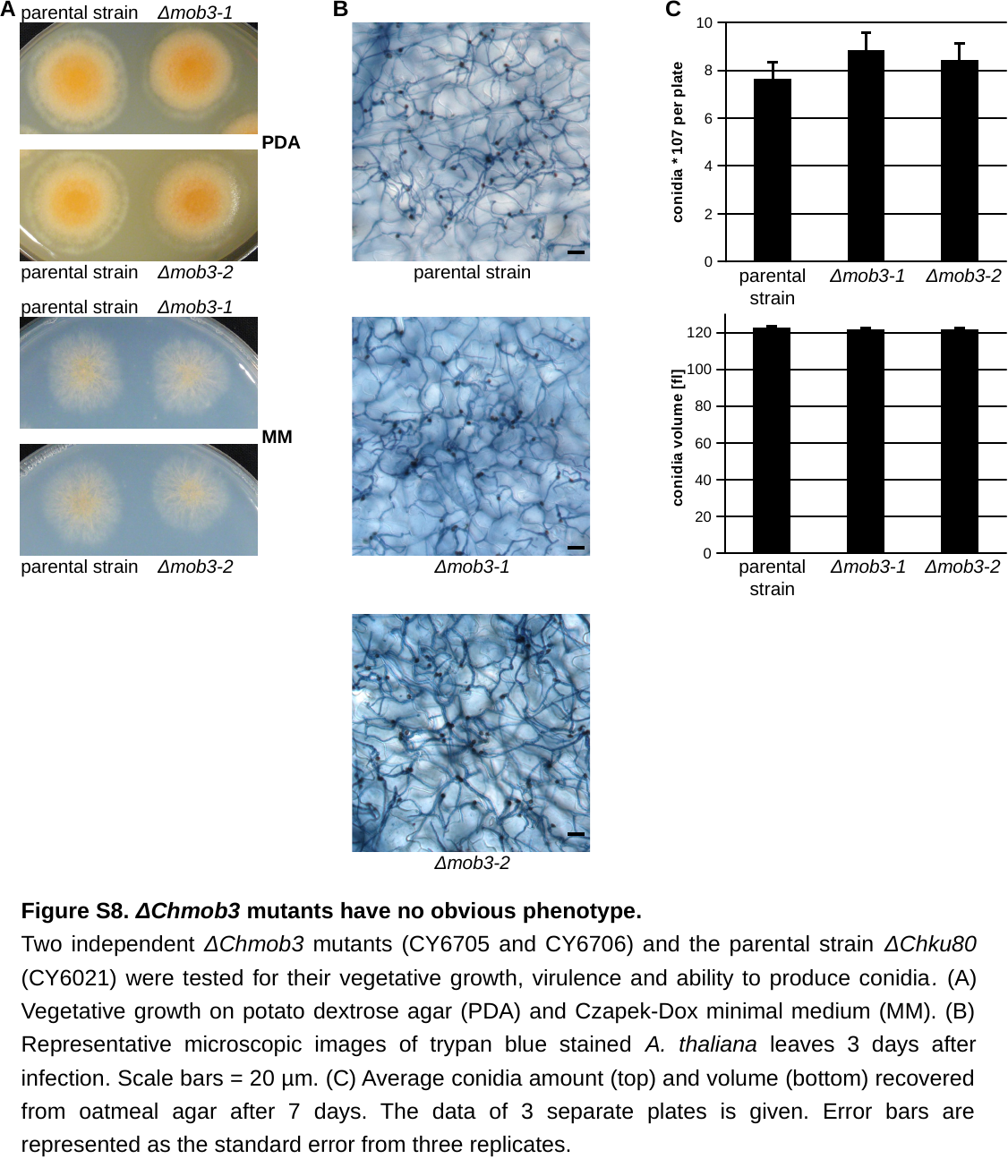
In the bottom chart in panel C (conidia volume [fl]), is the value for Δmob3-2 greater or less than 100? greater In the top chart in panel C (conidia * 10^7 per plate), which is larger, the value for the parental strain or the value for Δmob3-1? Δmob3-1 What is the y-axis label of the top chart in panel C? conidia * 107 per plate In the top chart in panel C (conidia * 10^7 per plate), is the value for the parental strain greater or less than 6? greater How many bars are shown in the bottom chart in panel C (conidia volume [fl])? 3 What is the y-axis label of the bottom chart in panel C? conidia volume [fl] In the top chart in panel C (conidia * 10^7 per plate), is the value for Δmob3-1 greater or less than 8? greater How many categories are plotted in the top chart in panel C (conidia * 10^7 per plate)? 3 What kind of chart is the top chart in panel C (conidia * 10^7 per plate)? bar chart In the top chart in panel C (conidia * 10^7 per plate), which category has the lowest value? parental strain What kind of chart is the bottom chart in panel C (conidia volume [fl])? bar chart